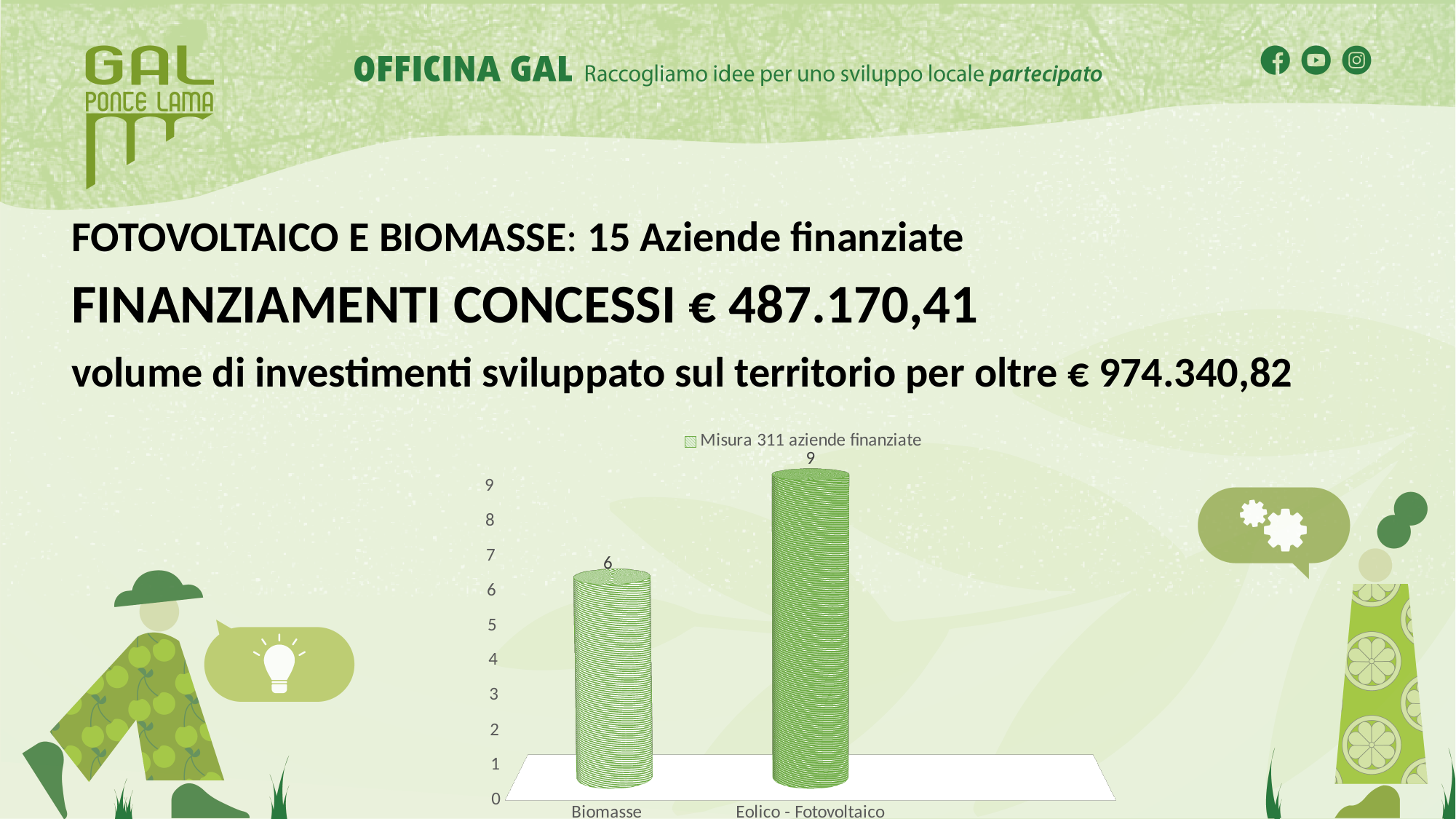
Which is larger, the value for Biomasse or the value for Eolico - Fotovoltaico? Eolico - Fotovoltaico Which category has the highest value? Eolico - Fotovoltaico How many series does the legend list? 1 What kind of chart is shown on the slide? bar chart What is the value for Eolico - Fotovoltaico? 9 What is the value for Biomasse? 6 Which category has the lowest value? Biomasse What is the difference between the values for Eolico - Fotovoltaico and Biomasse? 3 What is the legend entry of the chart? Misura 311 aziende finanziate How many categories are shown on the x axis? 2 What is the total of the two bars in the chart? 15 Is the value for Biomasse greater or less than 5? greater